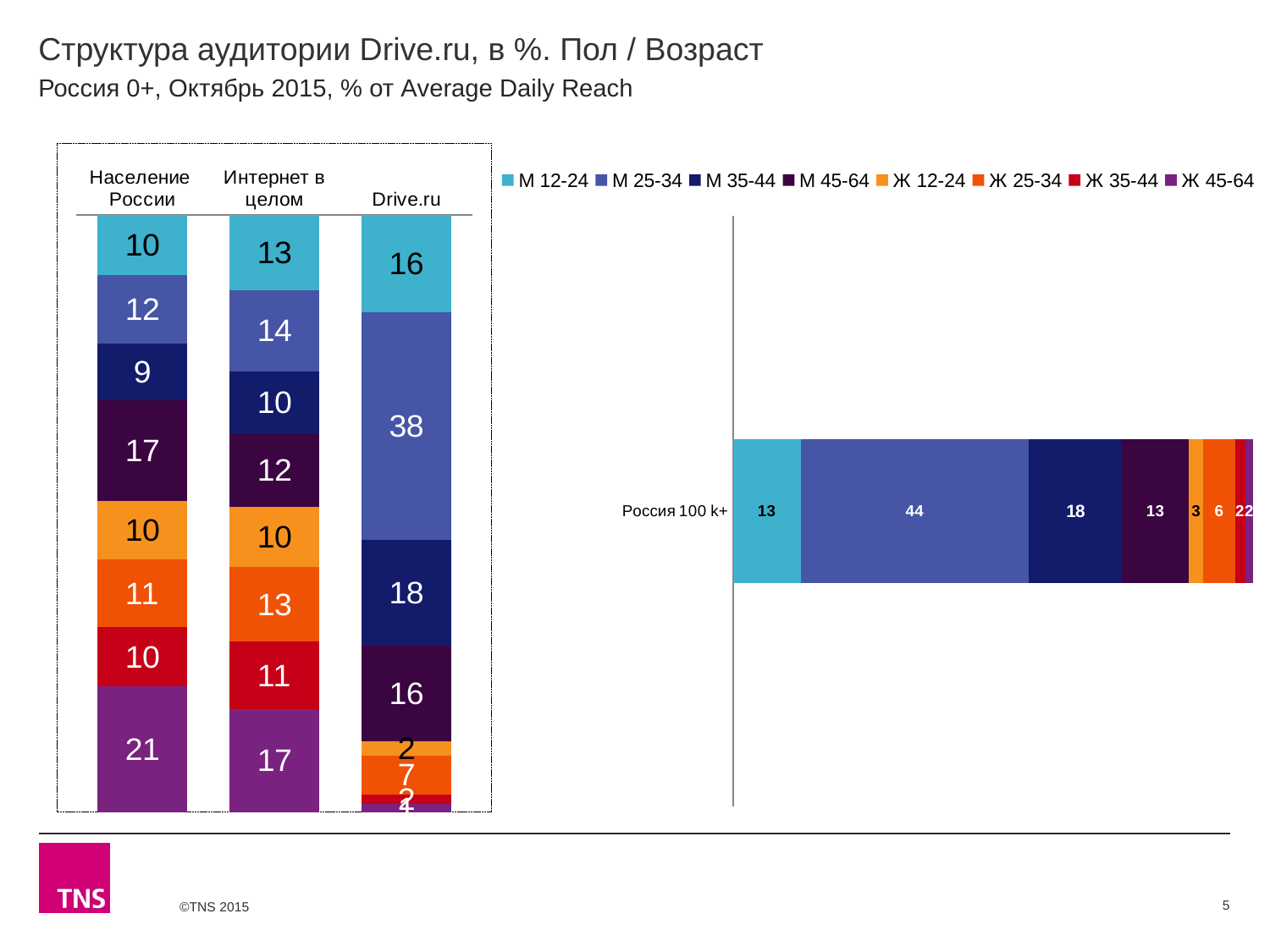
In the right chart (Россия 100 k+), what is the value of the М 25-34 segment? 44 In the left chart, which column has the larger Ж 45-64 segment: Население России or Интернет в целом? Население России In the left chart, what is the value of the bottom (Ж 45-64) segment for Население России? 21 In the left chart, what is the value of the top (М 12-24) segment for Интернет в целом? 13 In the left chart, what is the difference between the М 25-34 value for Drive.ru and the М 25-34 value for Интернет в целом? 24 In the right chart (Россия 100 k+), which segment is the largest? М 25-34 How many columns (categories) are shown in the left chart? 3 In the right chart (Россия 100 k+), what is the value of the М 35-44 segment? 18 In the left chart, what is the value of the М 25-34 segment for Drive.ru? 38 How many series does the legend list? 8 In the left chart, which segment is the largest in the Drive.ru column? М 25-34 In the left chart, what is the total of the Население России column? 100